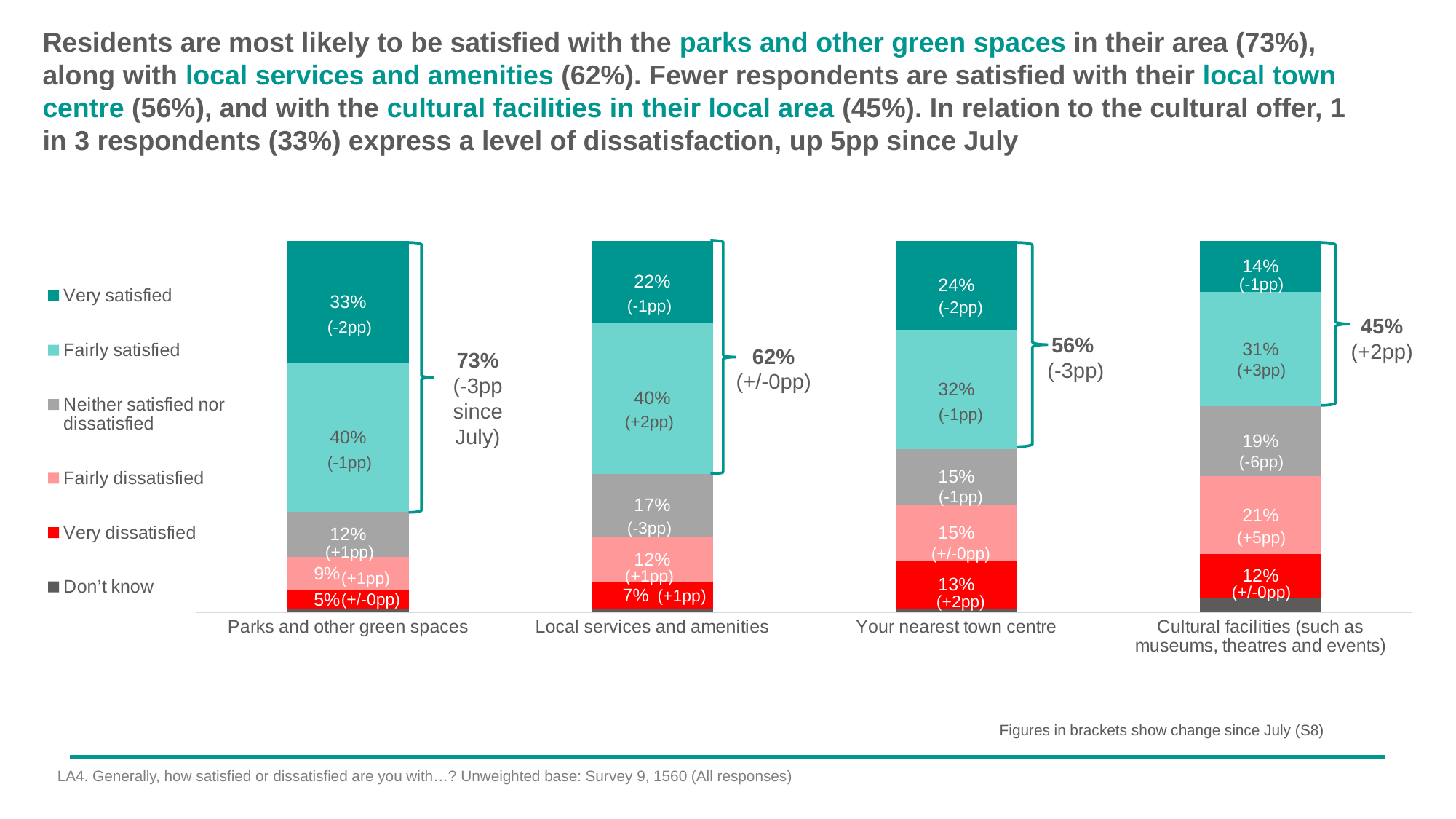
How many series does the legend list? 6 Which has a larger fairly dissatisfied share: your nearest town centre or cultural facilities? Cultural facilities What percentage of respondents are fairly dissatisfied with cultural facilities (such as museums, theatres and events)? 21% Which category has the lowest very satisfied percentage? Cultural facilities (such as museums, theatres and events) What is the difference in percentage points between the very satisfied share for parks and other green spaces and for local services and amenities? 11 Which category has the highest combined satisfied share? Parks and other green spaces What change since July is shown in brackets for the combined satisfied share for cultural facilities? +2pp How many categories are shown on the x axis? 4 What percentage of respondents are very dissatisfied with local services and amenities? 7% What percentage of respondents are very satisfied with parks and other green spaces? 33% What kind of chart is shown on the slide? Stacked bar chart What is the combined satisfied share (very plus fairly satisfied) shown for your nearest town centre? 56%